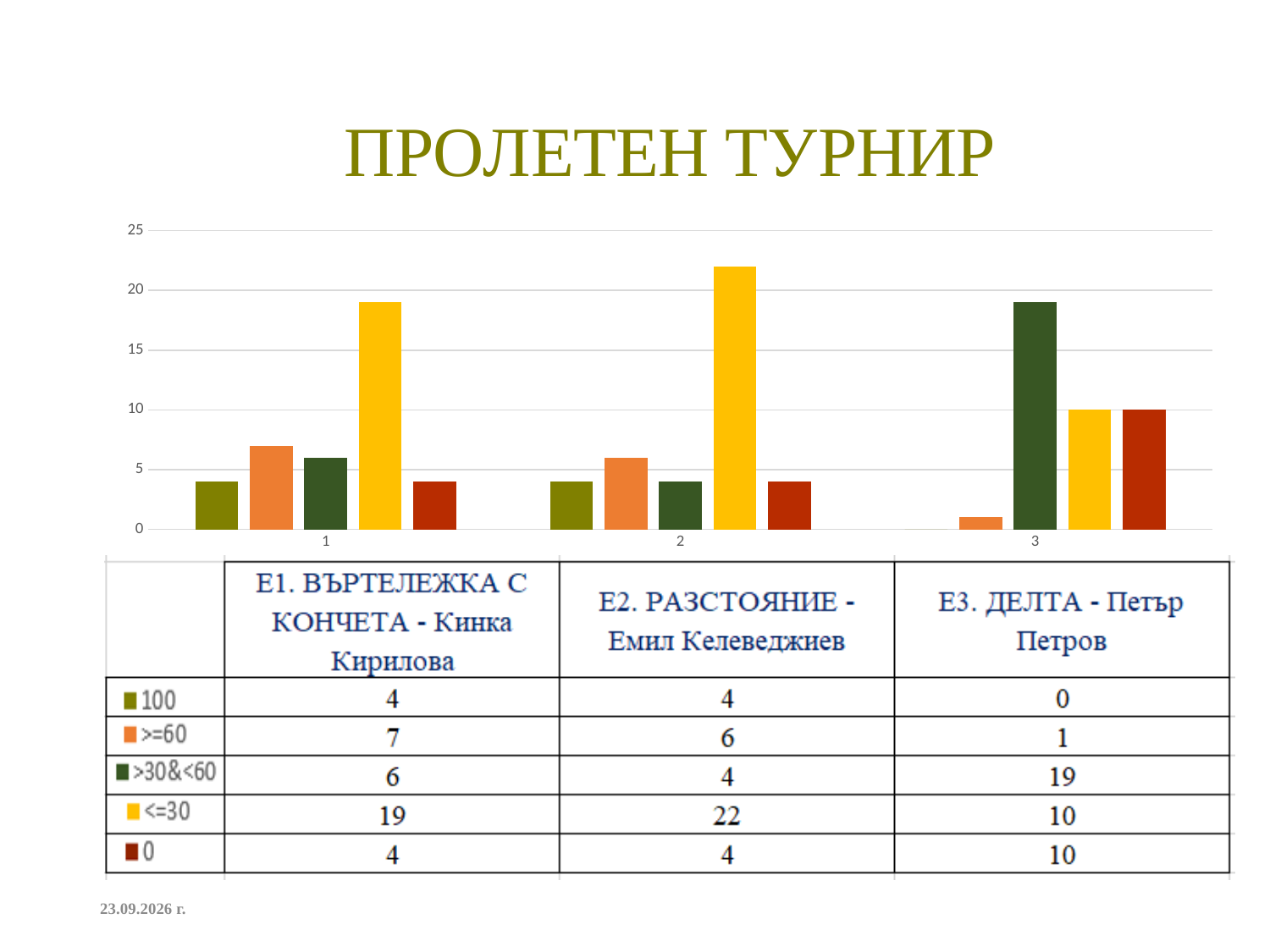
What is the value of the ">30&<60" series for category 3 (E3. ДЕЛТА - Петър Петров)? 19 Which category has the lowest value for the "100" series? 3 What is the title of the slide? ПРОЛЕТЕН ТУРНИР Which is larger: the "0" series value for category 3 or for category 1? category 3 What kind of chart is shown on the slide? bar chart How many series does the legend (data table) list? 5 Which category has the highest value for the "<=30" series? 2 Is the value of the "<=30" series for category 2 greater or less than 20? greater How many categories are shown on the x axis? 3 What is the difference between the "<=30" values for category 2 and category 1? 3 What is the value of the ">=60" series for category 1 (E1. ВЪРТЕЛЕЖКА С КОНЧЕТА - Кинка Кирилова)? 7 What is the value of the "<=30" series for category 2 (E2. РАЗСТОЯНИЕ - Емил Келеведжиев)? 22